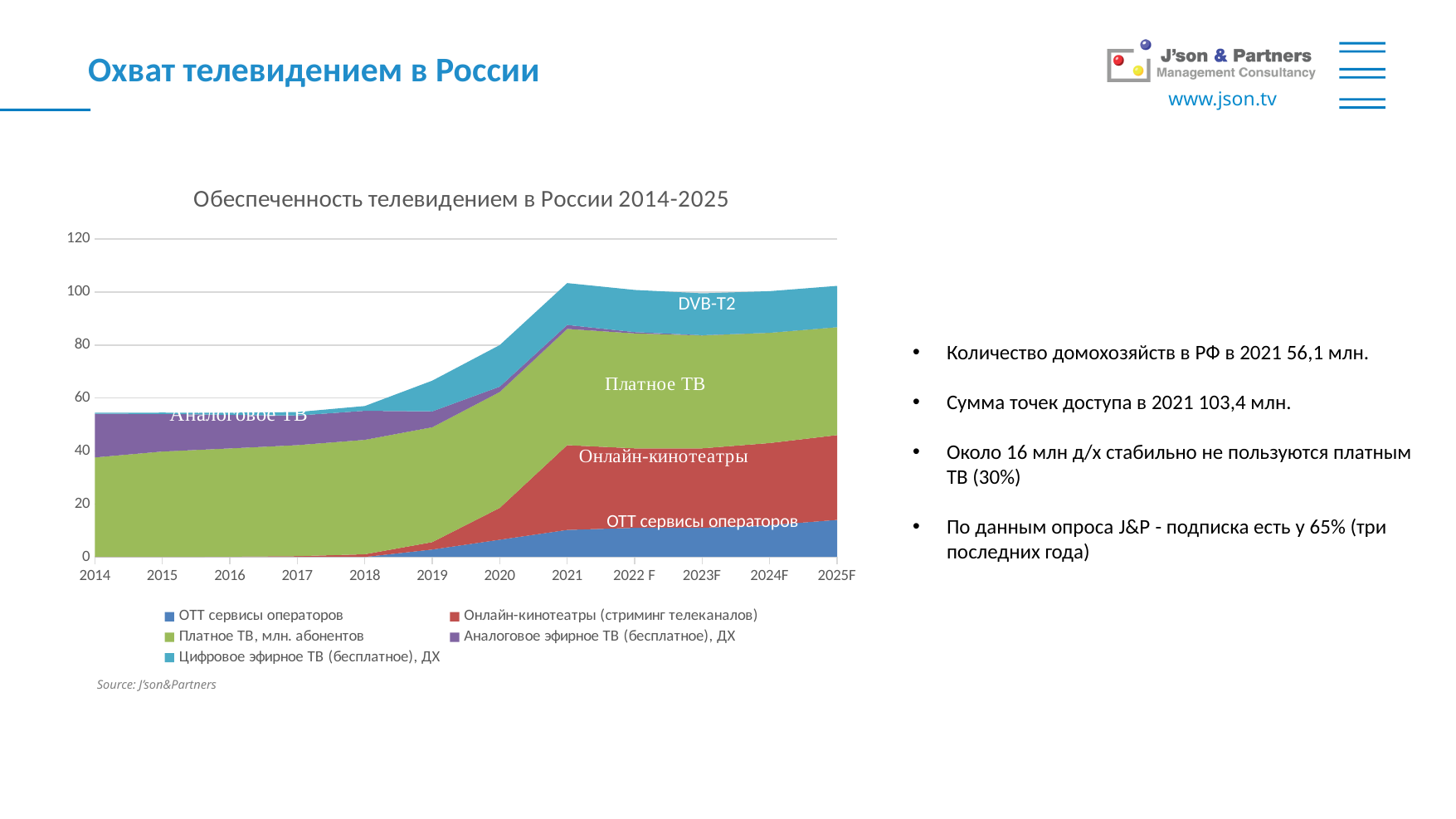
Is the total stacked value for 2018 greater or less than 40? greater How many series does the chart legend list? 5 How many years (points) are shown along the x axis of the chart? 12 Is the total stacked value for 2021 greater or less than 100? greater What is the title of the chart? Обеспеченность телевидением в России 2014-2025 Which year has the larger total stacked value, 2014 or 2021? 2021 Does the total stacked value rise or fall from 2014 to 2021? rise Is the total stacked value for 2014 greater or less than 60? less Which series is shown in green on the chart? Платное ТВ, млн. абонентов What kind of chart is shown on the slide? Stacked area chart